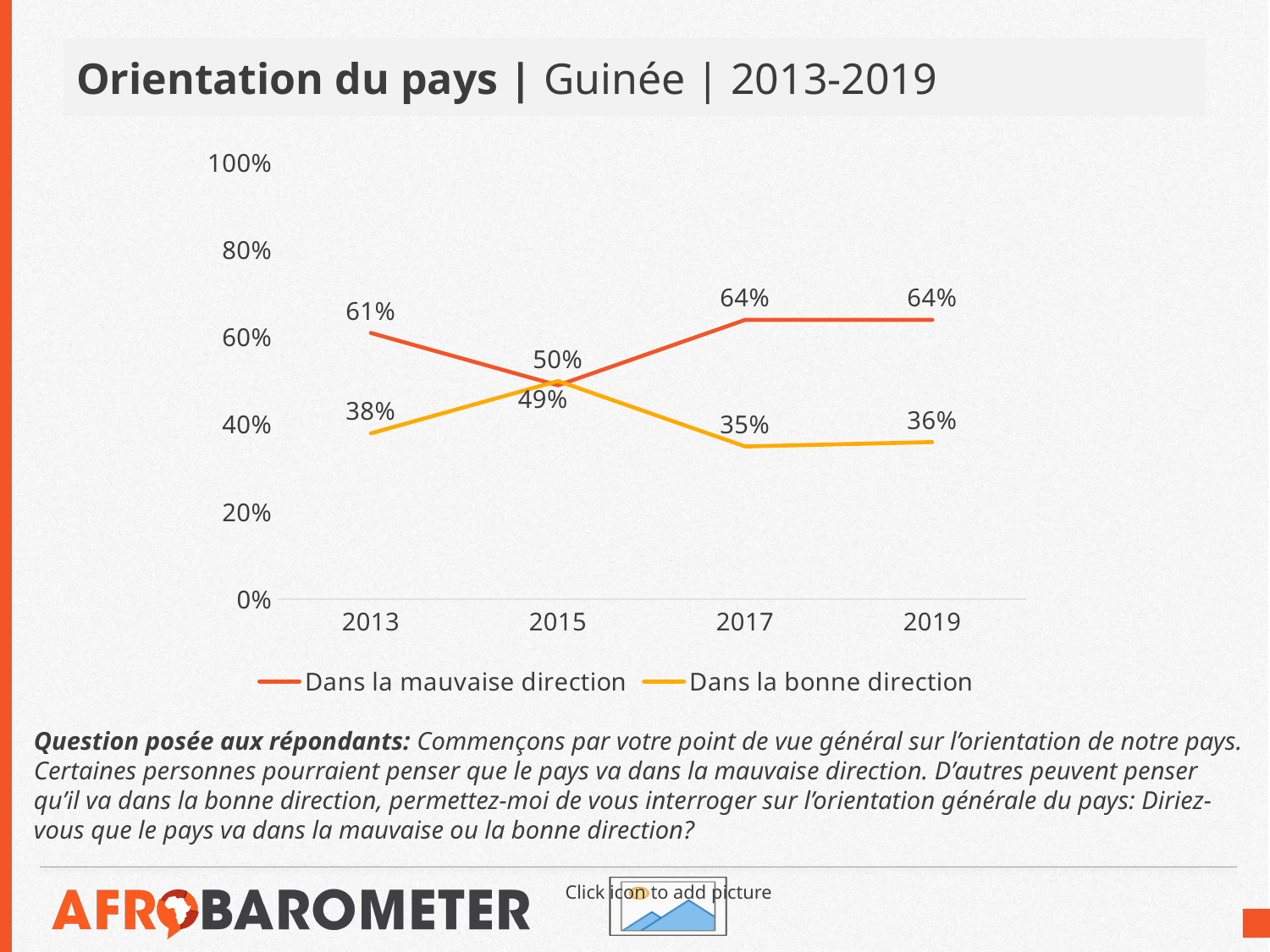
How many series does the legend list? 2 Which country does the chart title refer to? Guinée In which year is 'Dans la bonne direction' at its lowest? 2017 Which series has the larger value in 2013, 'Dans la mauvaise direction' or 'Dans la bonne direction'? Dans la mauvaise direction In which year is 'Dans la bonne direction' at its highest? 2015 What kind of chart is shown on the slide? line chart What is the value for 'Dans la bonne direction' in 2019? 36% Does the value for 'Dans la mauvaise direction' rise or fall between 2015 and 2017? rise What is the difference between 'Dans la mauvaise direction' and 'Dans la bonne direction' in 2019? 28 percentage points How many years are plotted along the x axis? 4 What is the value for 'Dans la bonne direction' in 2017? 35% What is the value for 'Dans la mauvaise direction' in 2013? 61%